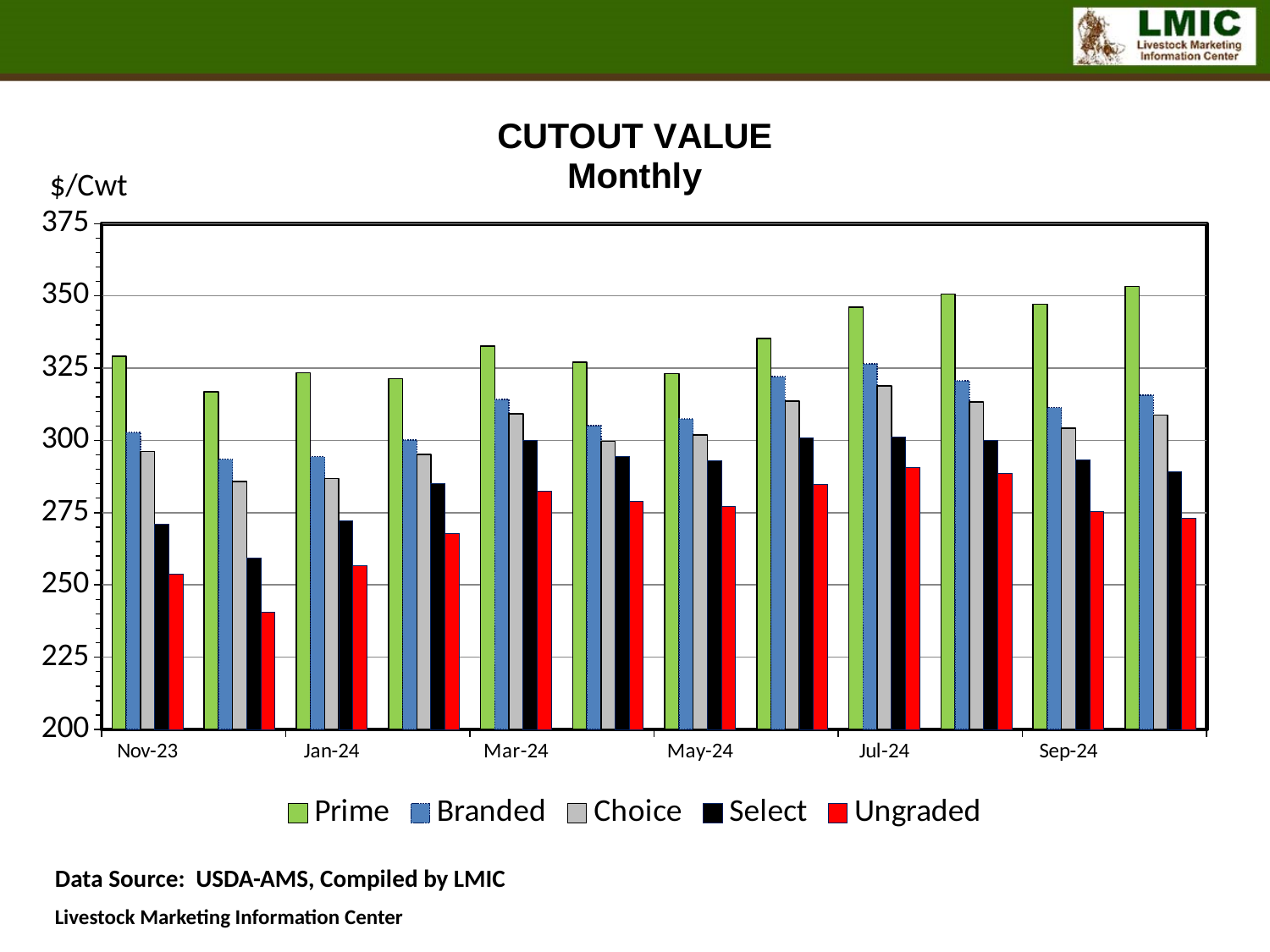
Is the value for Prime in Jul-24 greater or less than 325? greater Is the value for Choice in Mar-24 greater or less than 300? greater Is the value for Ungraded in Nov-23 greater or less than 275? less What kind of chart is shown on the slide? bar chart What unit is shown on the y axis of the chart? $/Cwt Which series has the lowest value in every month shown? Ungraded Which is larger, the Prime value in Jul-24 or the Prime value in Nov-23? Jul-24 Which is larger, the Select value in Mar-24 or the Select value in Nov-23? Mar-24 What are the series names listed in the legend? Prime, Branded, Choice, Select, Ungraded How many series does the legend list? 5 How many month labels are shown on the x axis? 6 Which series has the highest value in every month shown? Prime